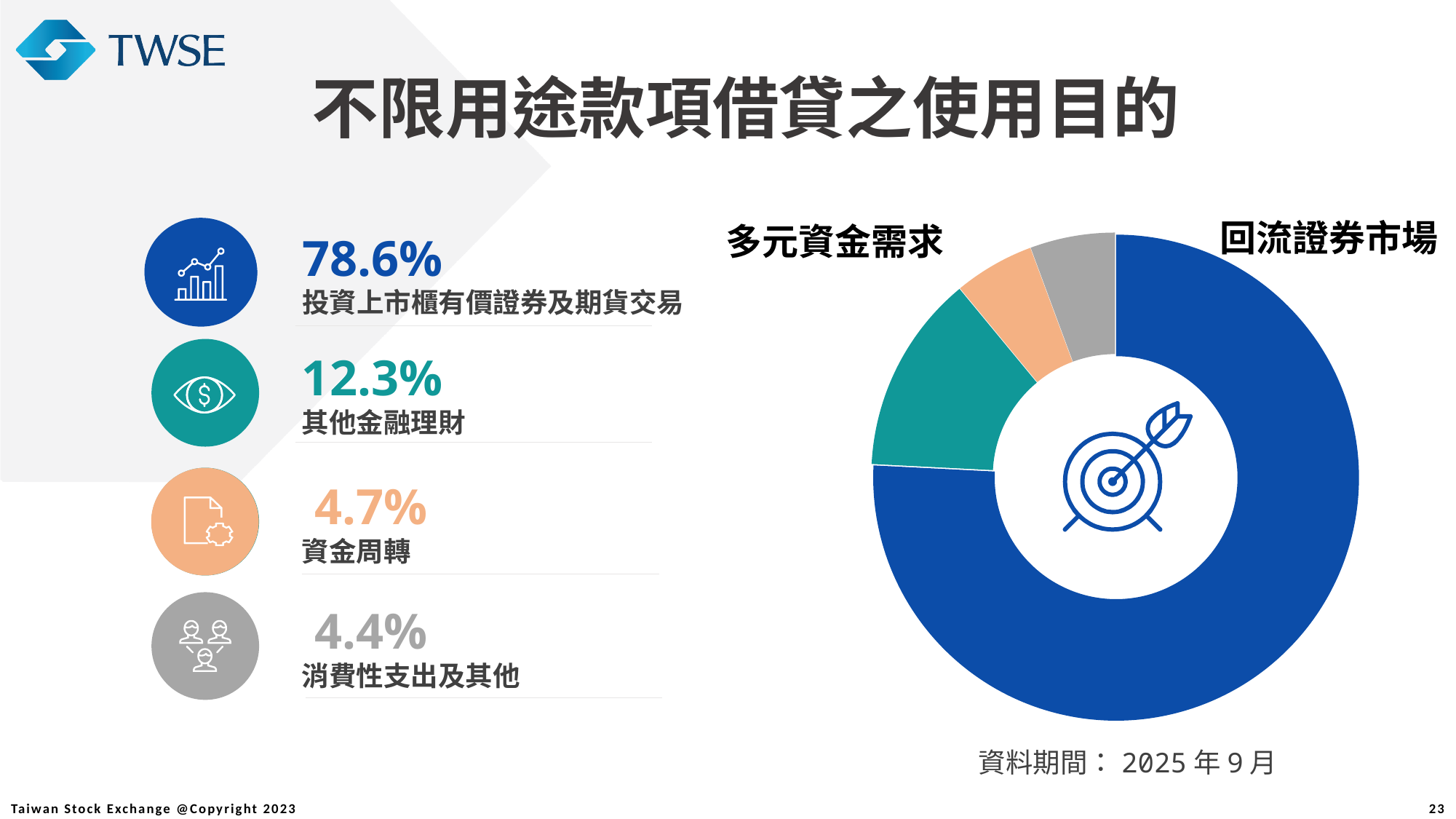
What share of the donut chart is 投資上市櫃有價證券及期貨交易? 78.6% What is the difference between the shares of 投資上市櫃有價證券及期貨交易 and 其他金融理財? 66.3% Which is larger, the share for 其他金融理財 or the share for 資金周轉? 其他金融理財 What colour is the segment for 其他金融理財 in the donut chart? Teal What kind of chart is shown on the slide? Donut (pie) chart What is the value for 資金周轉? 4.7% What is the value for 消費性支出及其他? 4.4% What is the value for 其他金融理財? 12.3% How many categories are shown in the donut chart? 4 What is the combined share of 資金周轉 and 消費性支出及其他? 9.1% Which category has the smallest share of the donut chart? 消費性支出及其他 Which category has the largest share of the donut chart? 投資上市櫃有價證券及期貨交易